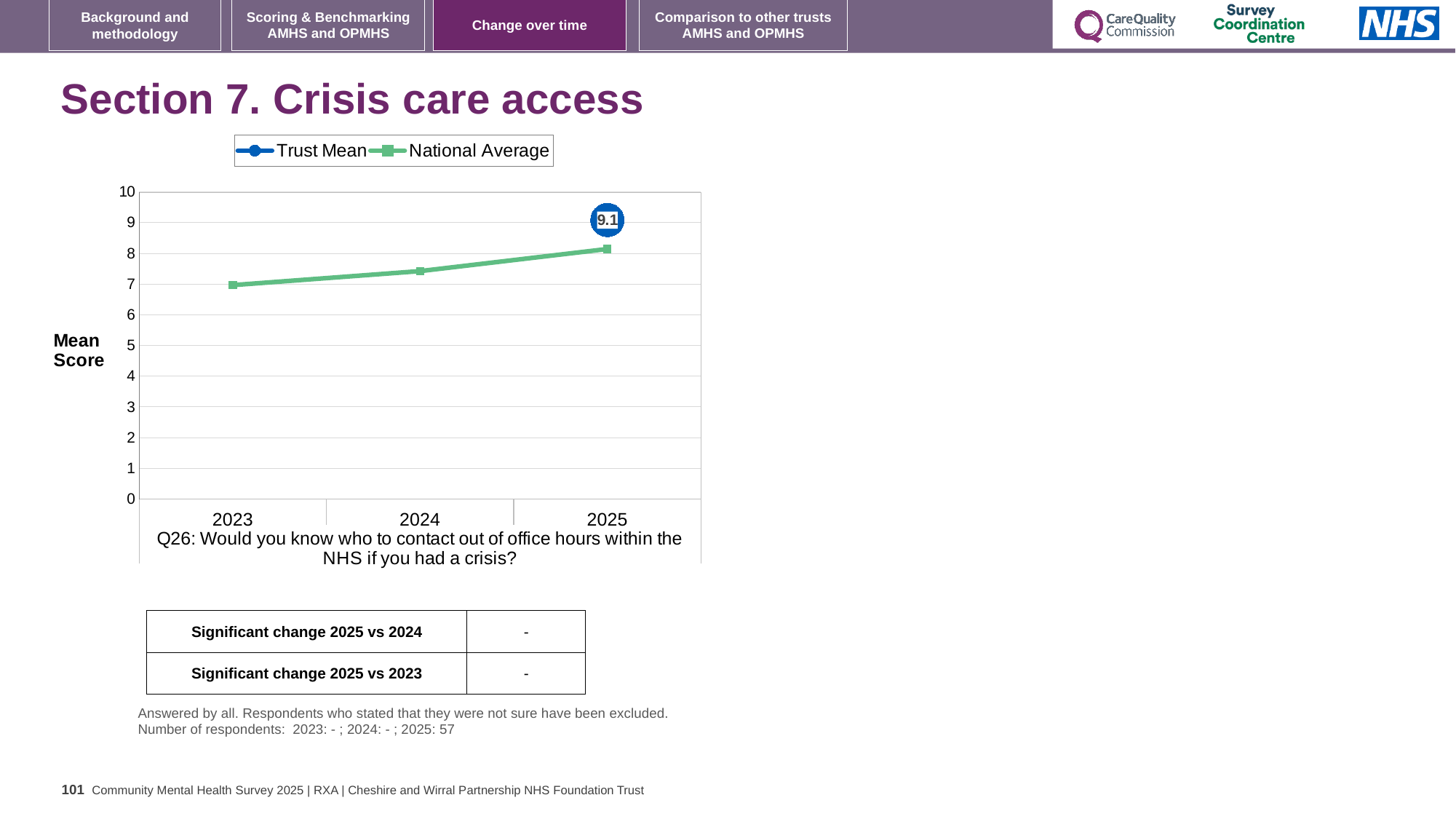
Is the National Average for 2025 greater or less than 7? greater What kind of chart is shown on the slide? line chart What is the label of the y axis? Mean Score Is the National Average for 2024 greater or less than 8? less How many years are shown on the x axis? 3 What is the Trust Mean score for 2025? 9.1 How many series does the legend list? 2 In which year is the National Average highest? 2025 Is the National Average for 2023 greater or less than 8? less Does the National Average rise or fall from 2023 to 2025? rise In 2025, which is larger: the Trust Mean or the National Average? Trust Mean In which year is the National Average lowest? 2023